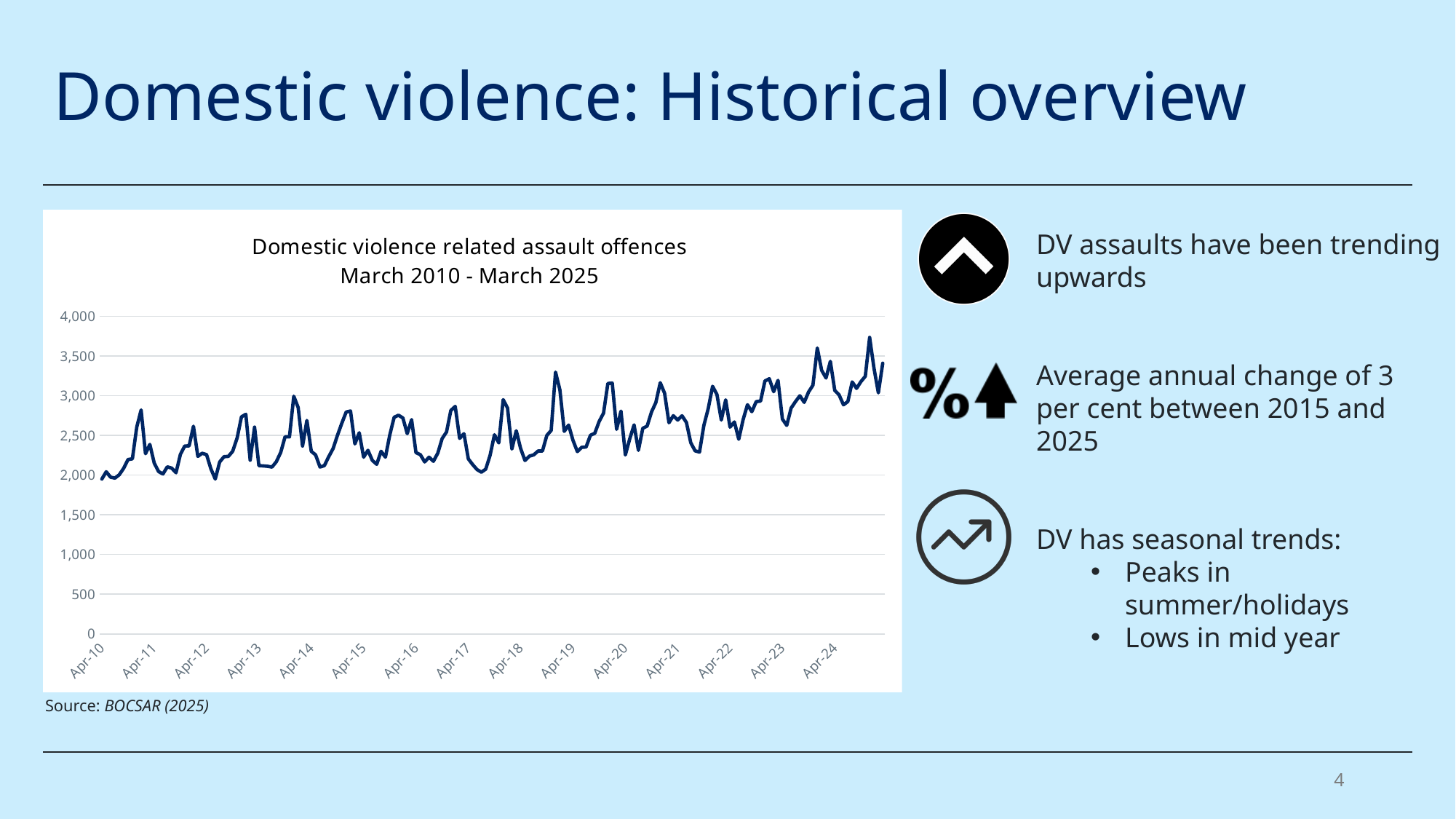
Is the value at Apr-10 greater or less than 2,500? less Is the lowest point on the chart greater or less than 2,500? less How many year labels are shown on the x axis? 15 Are all values on the chart greater or less than 1,500? greater Overall, do the values in the chart rise or fall from Apr-10 to the end of the series? rise What is the title of the chart? Domestic violence related assault offences March 2010 - March 2025 What is the highest value shown on the y axis? 4,000 Which x-axis label is the first on the chart? Apr-10 Which x-axis label is the last on the chart? Apr-24 What kind of chart is shown on the slide? line chart